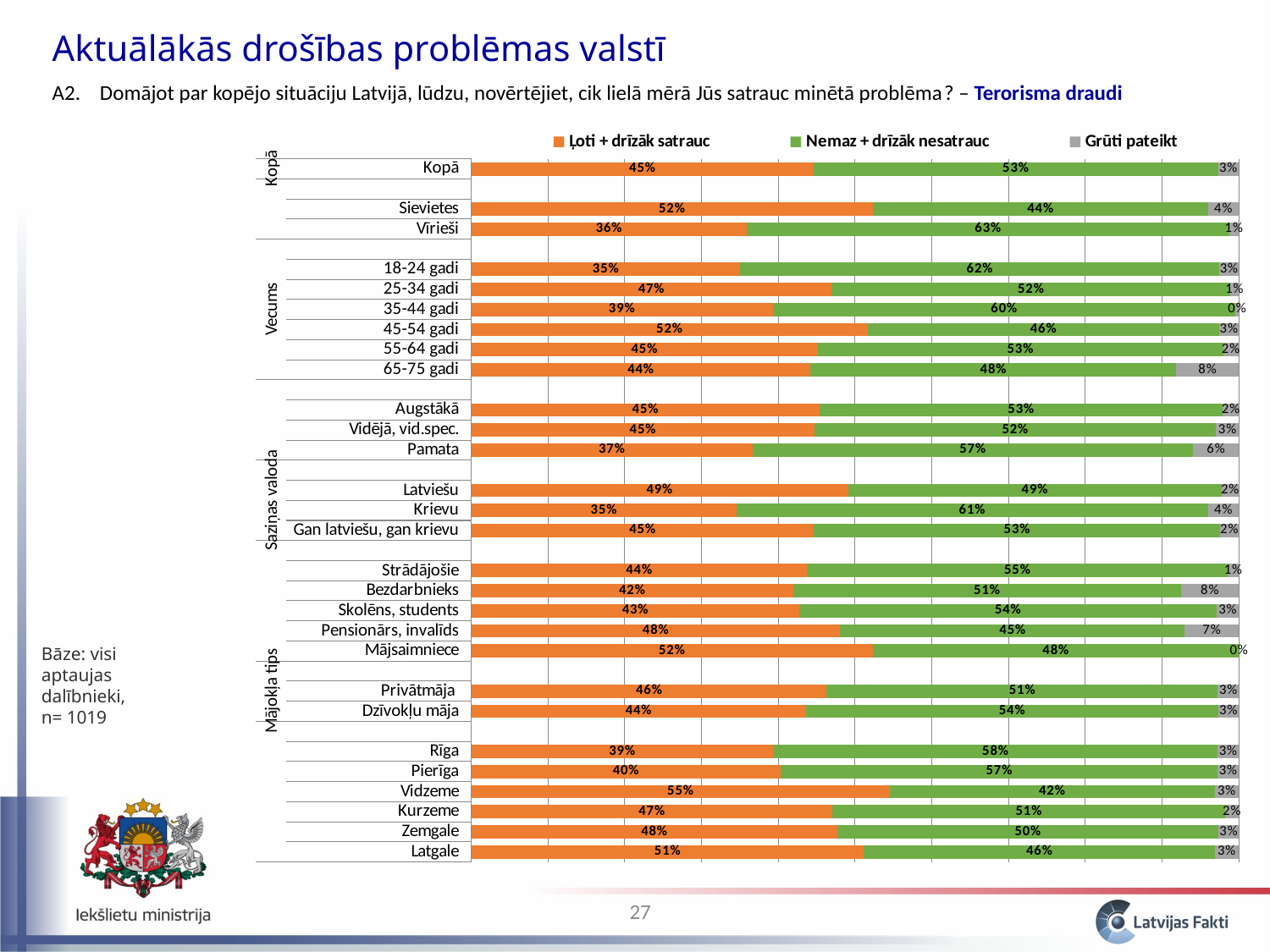
What is the value of "Ļoti + drīzāk satrauc" for Kopā? 45% What is the value of "Grūti pateikt" for 65-75 gadi? 8% Among the regions (Rīga, Pierīga, Vidzeme, Kurzeme, Zemgale, Latgale), which has the highest "Ļoti + drīzāk satrauc" value? Vidzeme What kind of chart is shown on the slide? Stacked bar chart Among the age groups, which has the lowest "Ļoti + drīzāk satrauc" value? 18-24 gadi What is the difference between the "Ļoti + drīzāk satrauc" values for Sievietes and Vīrieši? 16 percentage points How many categories (bars) are shown in the chart? 28 Which colour represents the "Grūti pateikt" series? Grey How many series does the legend list? 3 Which has a larger "Nemaz + drīzāk nesatrauc" value, Latviešu or Krievu? Krievu What is the value of "Nemaz + drīzāk nesatrauc" for Vīrieši? 63% What is the value of "Ļoti + drīzāk satrauc" for Vidzeme? 55%